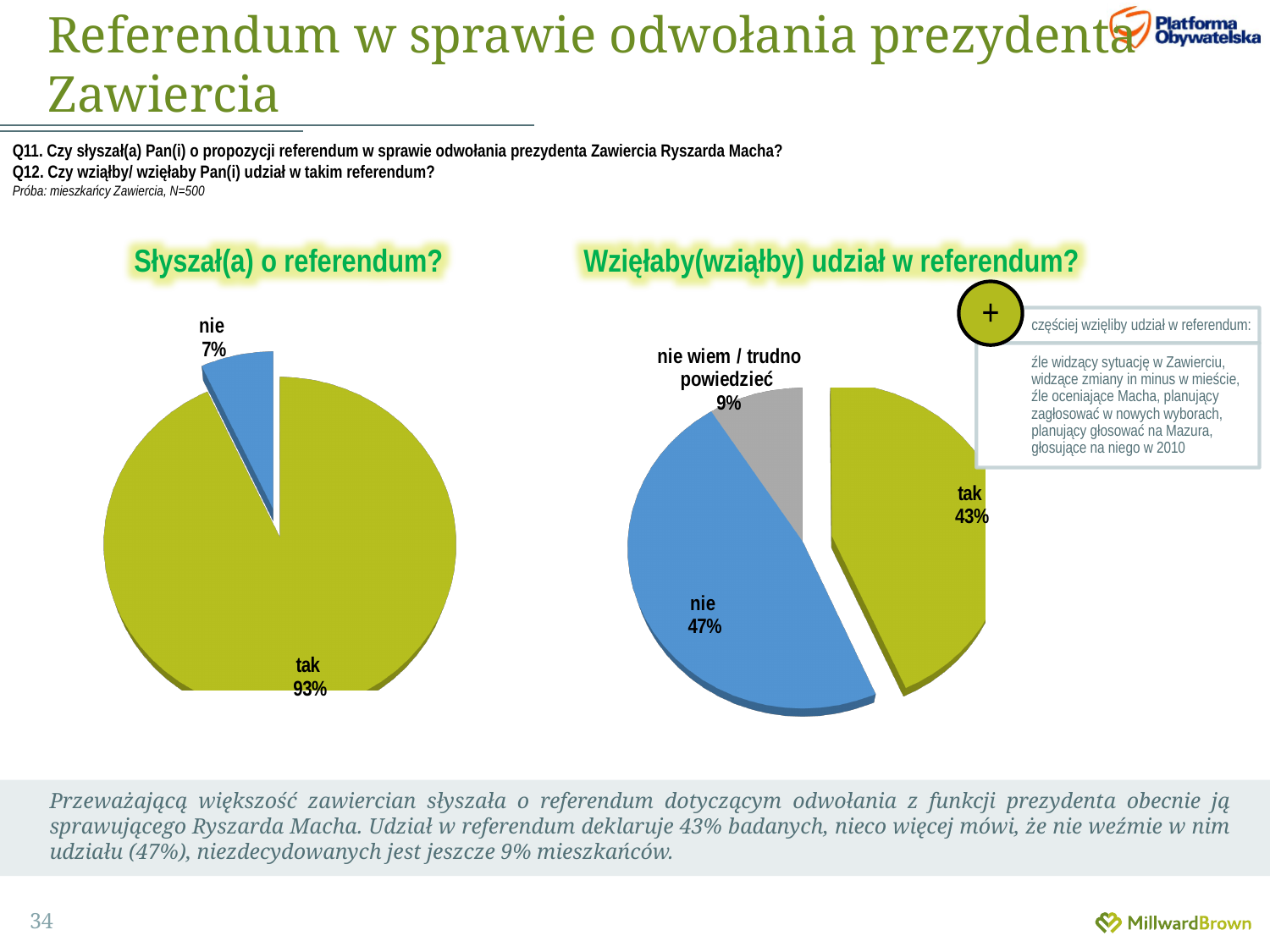
In the chart titled "Wzięłaby(wziąłby) udział w referendum?", what is the difference between the "nie" and "tak" shares? 4 percentage points In the chart titled "Wzięłaby(wziąłby) udział w referendum?", how many slices does the pie have? 3 In the chart titled "Wzięłaby(wziąłby) udział w referendum?", what colour is the "nie" slice? Blue In the chart titled "Wzięłaby(wziąłby) udział w referendum?", which answer has the largest share? nie In the chart titled "Wzięłaby(wziąłby) udział w referendum?", which answer has the smallest share? nie wiem / trudno powiedzieć In the chart titled "Wzięłaby(wziąłby) udział w referendum?", what percentage answered "nie wiem / trudno powiedzieć"? 9% In the chart titled "Wzięłaby(wziąłby) udział w referendum?", what percentage answered "tak"? 43% What type of chart is used for "Słyszał(a) o referendum?"? Pie chart In the chart titled "Wzięłaby(wziąłby) udział w referendum?", what percentage answered "nie"? 47% In the chart titled "Słyszał(a) o referendum?", what percentage answered "nie"? 7% In the chart titled "Słyszał(a) o referendum?", what is the difference between the "tak" and "nie" shares? 86 percentage points In the chart titled "Słyszał(a) o referendum?", what percentage answered "tak"? 93%